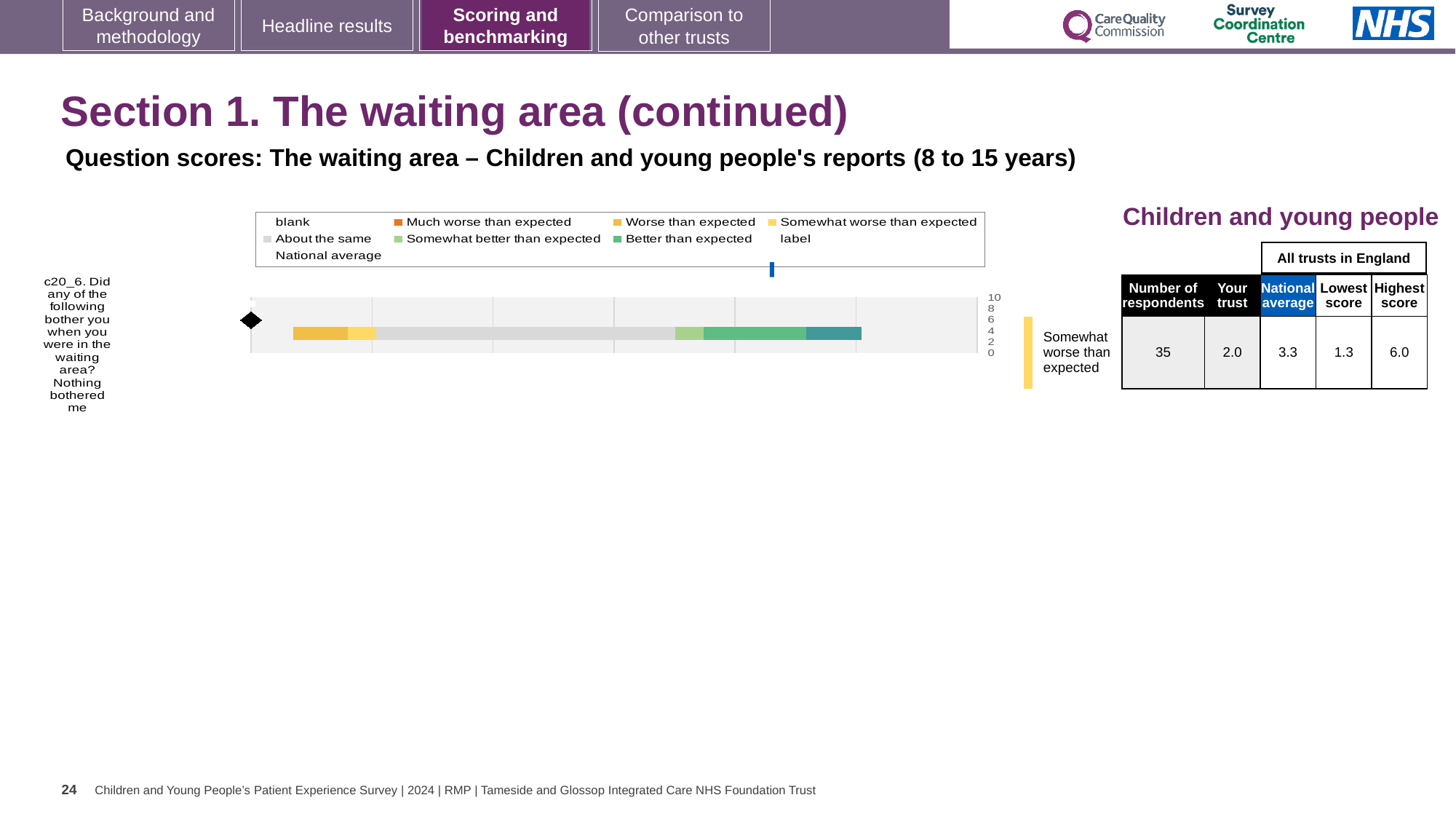
In the table beside the chart, what is the highest score among all trusts in England for question c20_6? 6.0 In the table beside the chart, what is the number of respondents for question c20_6? 35 How many entries does the chart legend list? 9 What is the difference between the highest score and the lowest score for question c20_6 in the table beside the chart? 4.7 Is the 'Your trust' score for question c20_6 larger or smaller than the national average? smaller How many survey questions (categories) are plotted in the bar chart? 1 In the table beside the chart, what is the national average score for question c20_6? 3.3 What kind of chart is shown on the slide? bar chart Which question code is plotted in the bar chart? c20_6 What rating label is shown to the right of the bar chart for question c20_6? Somewhat worse than expected In the table beside the chart, what is the 'Your trust' score for question c20_6? 2.0 In the table beside the chart, what is the lowest score among all trusts in England for question c20_6? 1.3